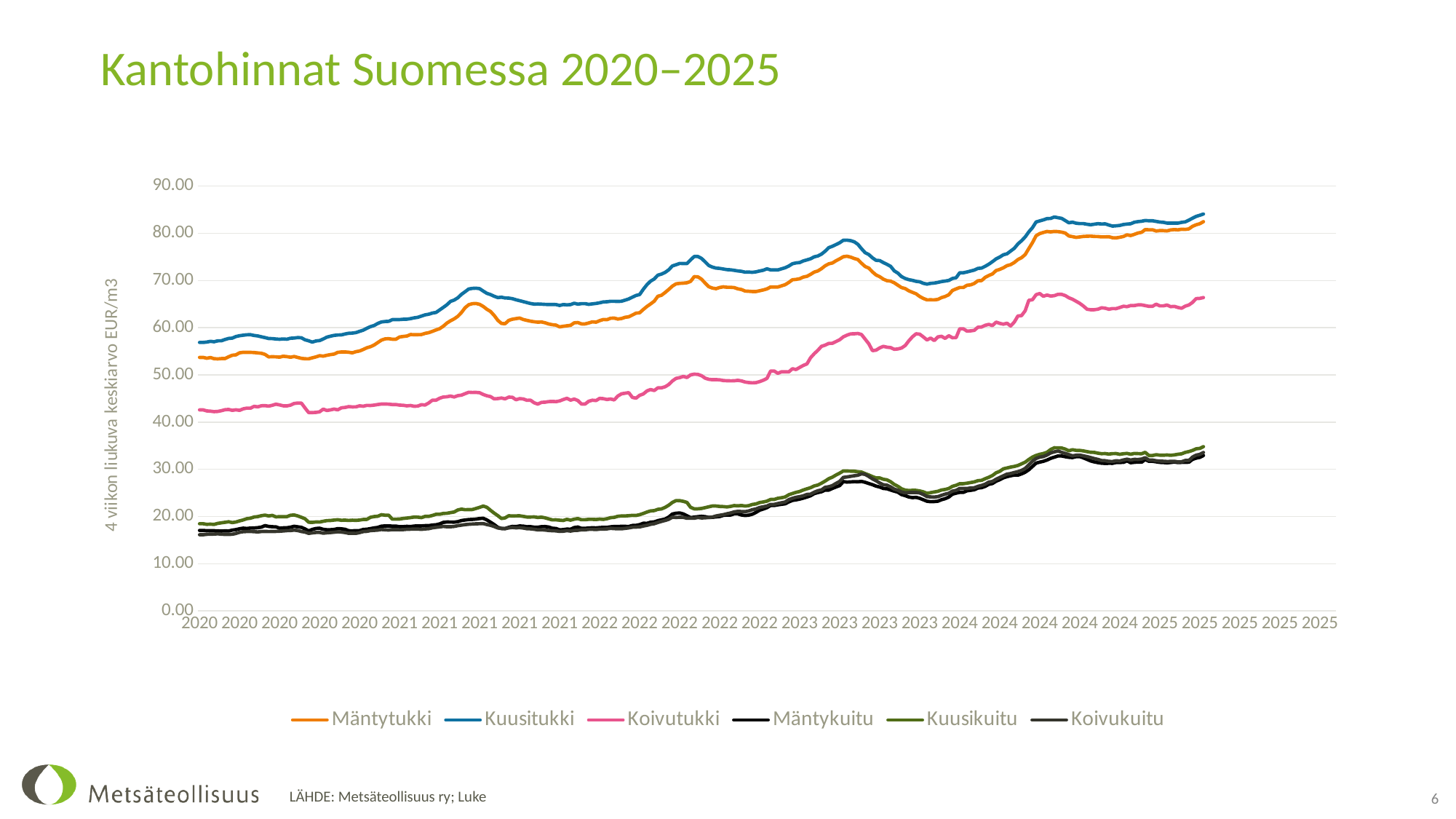
Which is larger in 2024, Kuusikuitu or Mäntykuitu? Kuusikuitu Is the value for Kuusitukki at the end of 2025 greater or less than 80? greater Is the value for Koivutukki at the start of 2020 greater or less than 50? less How many series does the legend list? 6 Is the value for Mäntytukki at the start of 2020 greater or less than 60? less Does the Kuusitukki series rise or fall overall from 2020 to 2025? rise What kind of chart is shown on the slide? line chart Which is larger in 2022, Mäntytukki or Koivutukki? Mäntytukki Which series has the highest values at the end of the chart in 2025? Kuusitukki What is the title of the chart? Kantohinnat Suomessa 2020–2025 What is the label of the vertical axis? 4 viikon liukuva keskiarvo EUR/m3